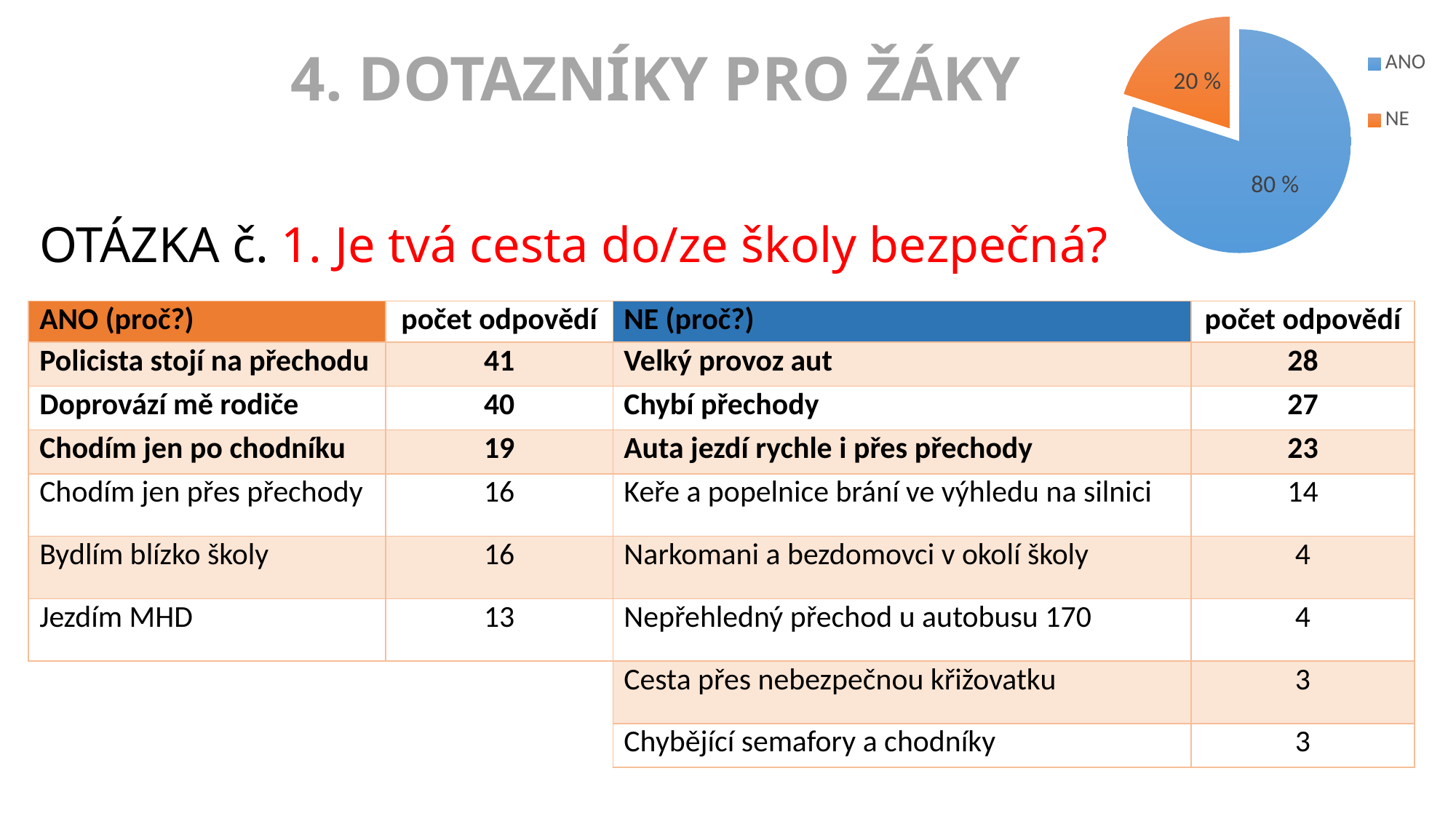
How many entries does the pie chart's legend list? 2 How many slices does the pie chart have? 2 What are the two legend entries of the pie chart? ANO and NE In the pie chart, which is larger, ANO or NE? ANO In the pie chart, what is the difference between the ANO share and the NE share? 60 % In the pie chart, what share is labelled for NE? 20 % In the pie chart, what share is labelled for ANO? 80 % Which slice of the pie chart is the smallest? NE What colour is the ANO slice in the pie chart? blue Which slice of the pie chart is the largest? ANO What kind of chart is shown in the top right of the slide? pie chart What share of the pie chart does the NE slice take? 20 %